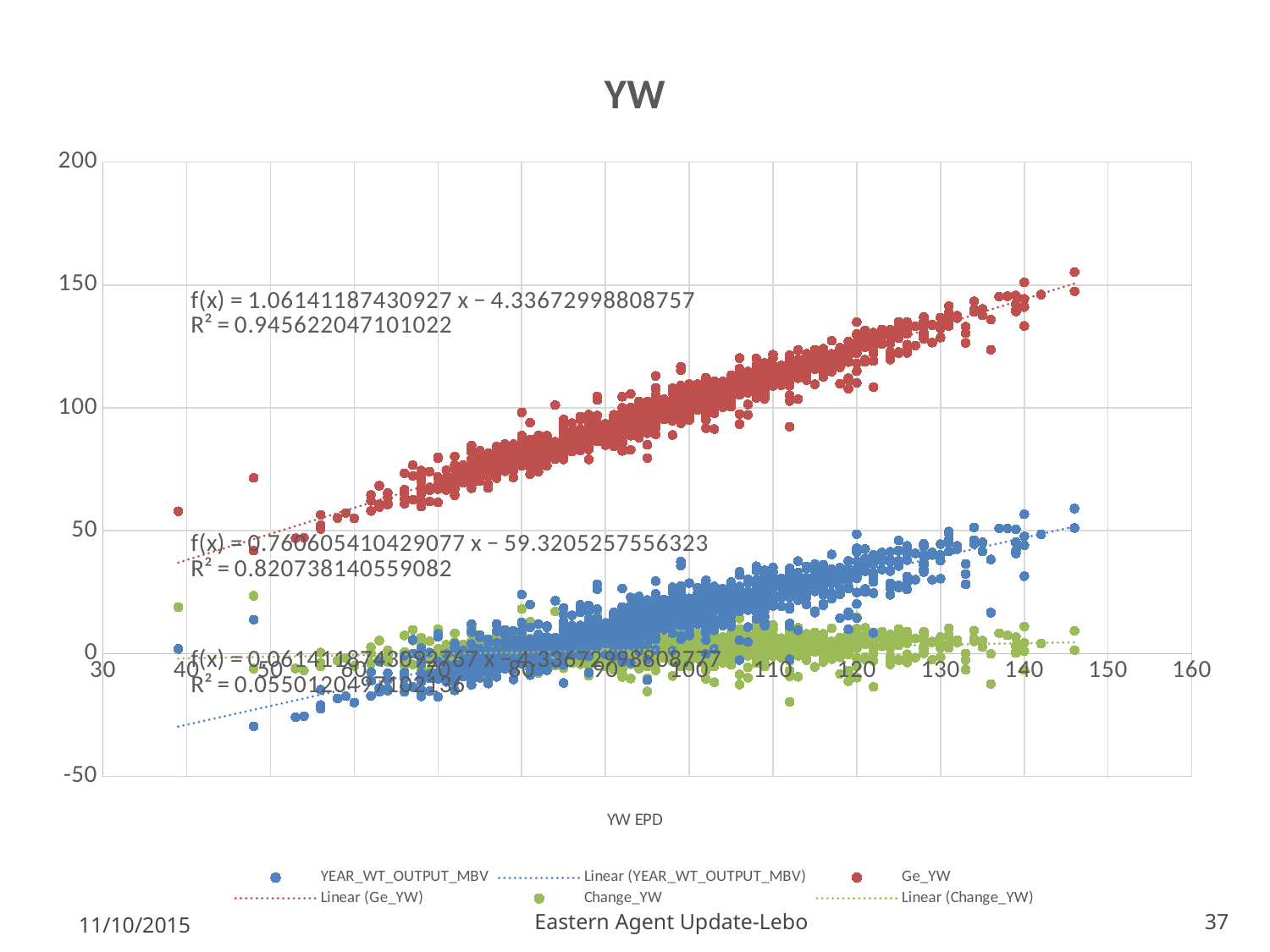
What is the title of the chart? YW At a YW EPD of 100, which series has larger values: Ge_YW or YEAR_WT_OUTPUT_MBV? Ge_YW What kind of chart is shown on the slide? Scatter chart How many entries does the chart legend list? 6 Do the Ge_YW values rise or fall as YW EPD increases along the x axis? Rise Which series has the highest plotted values across the chart: Ge_YW, YEAR_WT_OUTPUT_MBV or Change_YW? Ge_YW What is the label on the x axis of the chart? YW EPD Are the Ge_YW values at a YW EPD of 60 greater or less than 100? less What is the slope in the trendline equation with intercept −59.3205257556323? 0.760605410429077 What is the R² value shown for the top trendline equation (f(x) = 1.06141187430927 x − 4.33672998808757)? 0.945622047101022 Are the Ge_YW values at a YW EPD of 140 greater or less than 100? greater What is the R² value shown for the trendline equation f(x) = 0.760605410429077 x − 59.3205257556323? 0.820738140559082